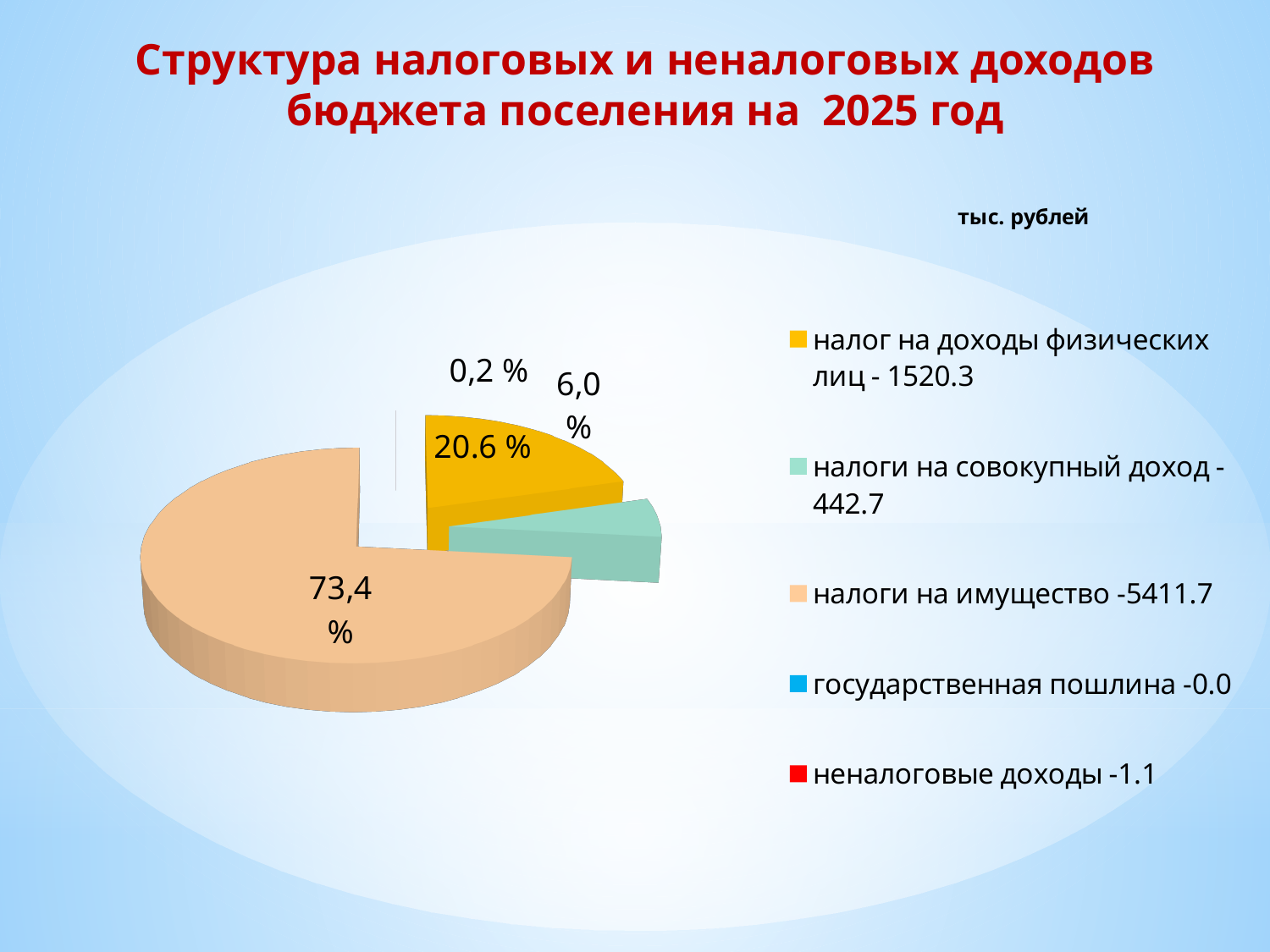
What is the value shown in the legend for налоги на совокупный доход? 442.7 What is the value shown in the legend for неналоговые доходы? 1.1 What kind of chart is shown on the slide? pie chart Which is larger: налог на доходы физических лиц or налоги на совокупный доход? налог на доходы физических лиц What share of the pie does налог на доходы физических лиц take? 20.6 % Which category has the smallest value? государственная пошлина What is the value shown in the legend for налог на доходы физических лиц? 1520.3 What is the difference between налоги на имущество and налог на доходы физических лиц? 3891.4 What is the value shown in the legend for налоги на имущество? 5411.7 What share of the pie does налоги на имущество take? 73,4 % How many categories does the legend list? 5 Which category has the largest value? налоги на имущество